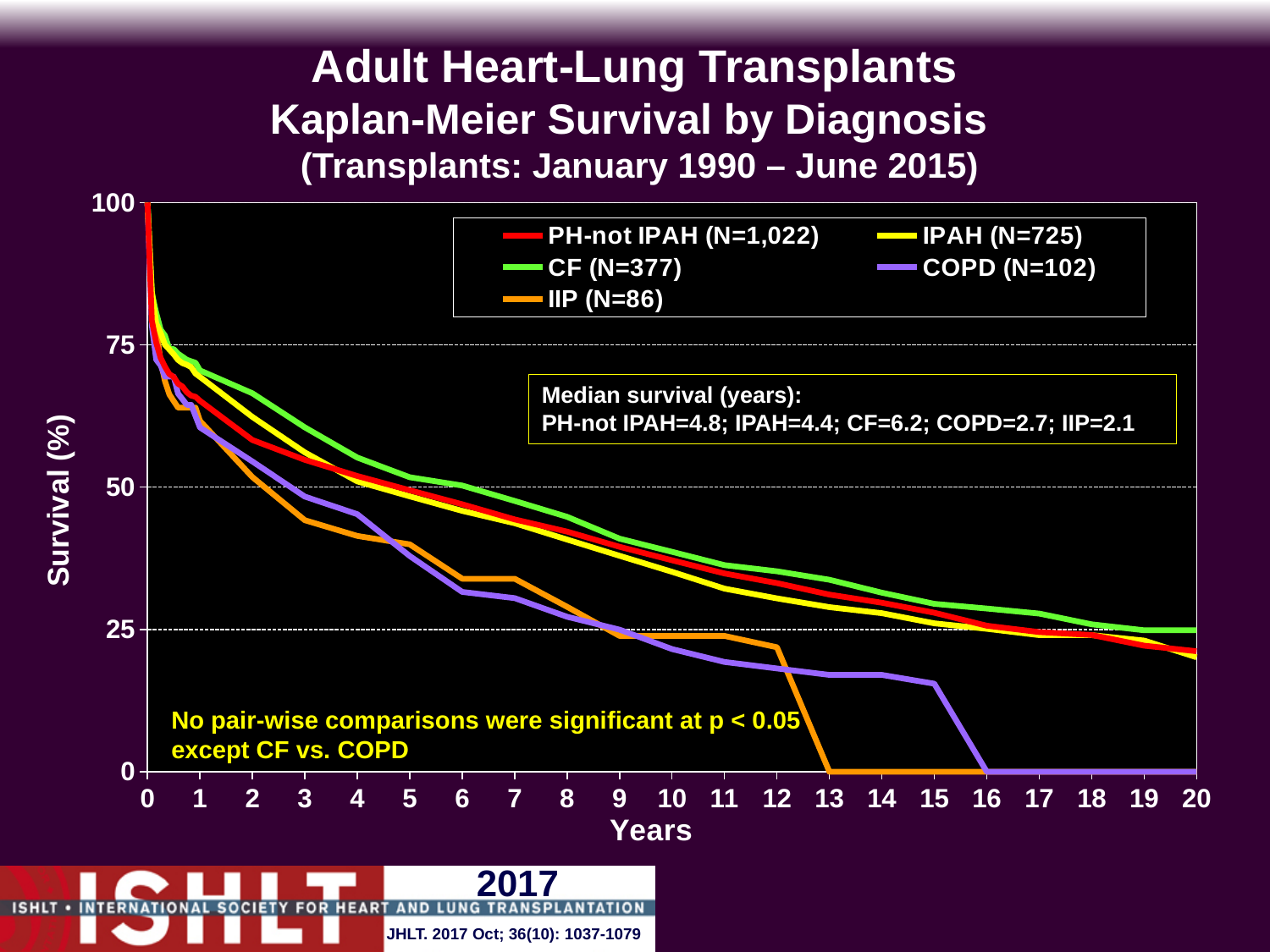
How many diagnosis groups (series) does the legend list? 5 What is the median survival in years for the IIP group? 2.1 What is the difference in median survival (years) between the CF and COPD groups? 3.5 Do the survival curves rise or fall as years increase? fall What is the median survival in years for the CF group? 6.2 What is the N for the COPD group shown in the legend? 102 Which group has the larger median survival, PH-not IPAH or IPAH? PH-not IPAH Which diagnosis group has the lowest median survival? IIP At which year does the IIP survival curve reach 0%? 13 Which diagnosis group has the highest median survival? CF What kind of chart is shown on the slide? line chart Is the survival for the IPAH group at 10 years greater or less than 25? greater